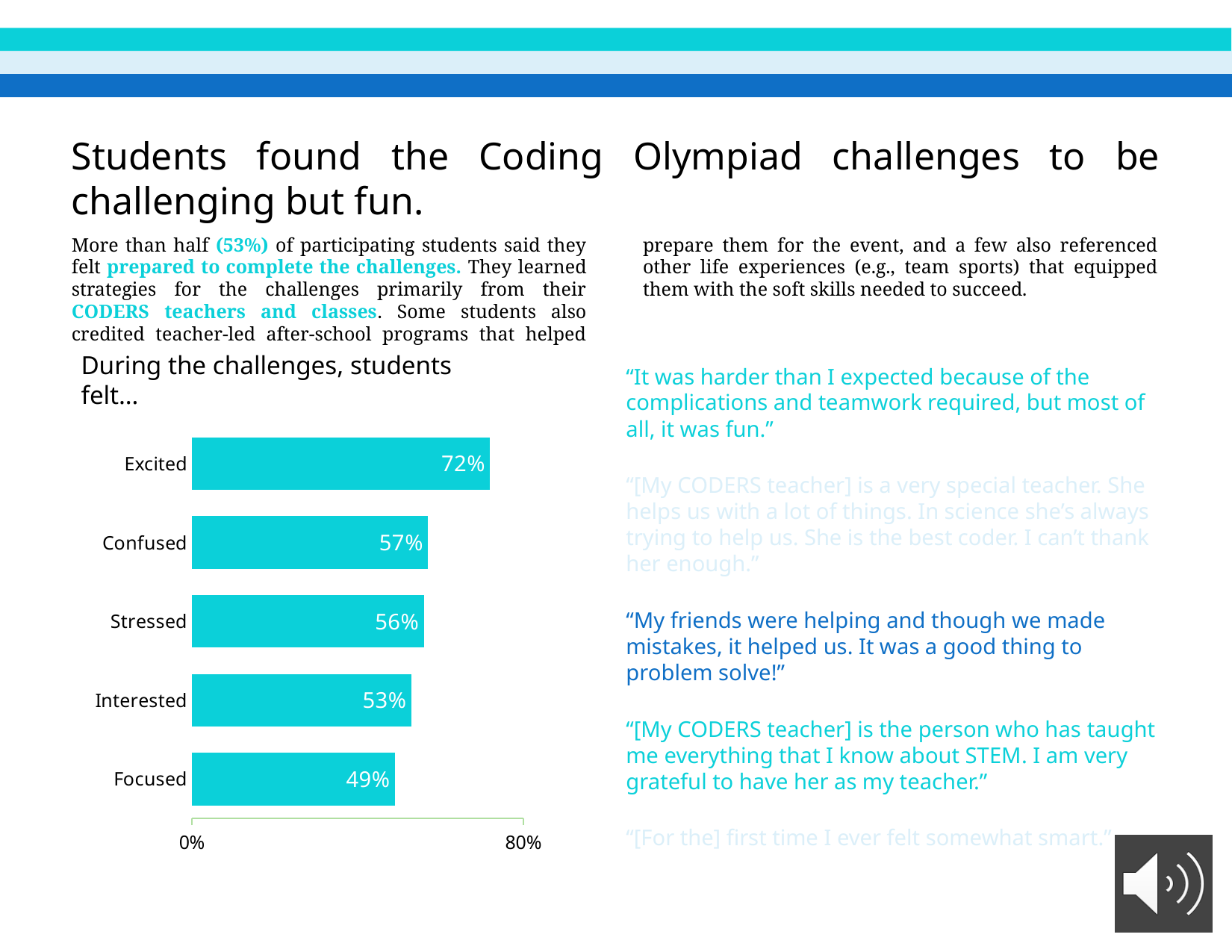
Which feeling has the lowest percentage in the chart? Focused What type of chart is shown on the slide? Bar chart What percentage of students felt excited during the challenges? 72% Which is larger: the percentage of students who felt stressed or the percentage who felt interested? Stressed What is the maximum value shown on the chart's horizontal axis? 80% Which feeling has the highest percentage in the chart? Excited What percentage of students felt focused during the challenges? 49% How many feelings are shown in the chart? 5 What is the difference between the percentage of students who felt confused and those who felt interested? 4% What is the title of the chart? During the challenges, students felt... What is the difference between the percentage of students who felt excited and those who felt focused? 23% What percentage of students felt confused during the challenges? 57%